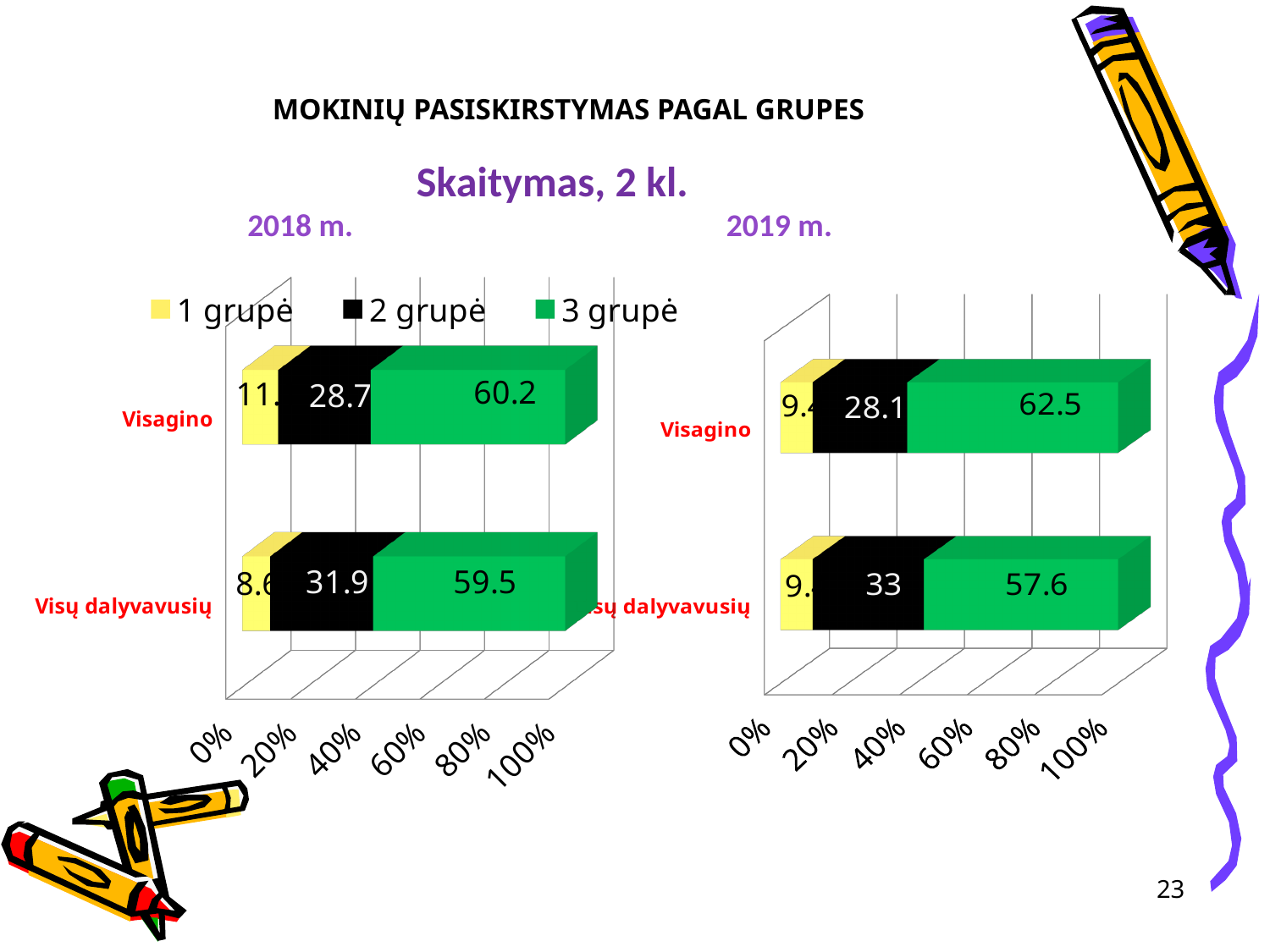
In the 2019 m. chart, what is the value of 3 grupė for Visų dalyvavusių? 57.6 In the 2018 m. chart, what is the value of 1 grupė for Visų dalyvavusių? 8.6 In the 2019 m. chart, what is the value of 3 grupė for Visagino? 62.5 In the 2018 m. chart, which category has the larger 3 grupė value, Visagino or Visų dalyvavusių? Visagino In the 2019 m. chart, what is the value of 2 grupė for Visų dalyvavusių? 33 What are the legend entries shown above the 2018 m. chart? 1 grupė, 2 grupė, 3 grupė In the 2018 m. chart, what is the value of 3 grupė for Visagino? 60.2 What kind of chart is the 2018 m. chart? Stacked bar chart In the 2018 m. chart, what is the value of 2 grupė for Visų dalyvavusių? 31.9 In the 2019 m. chart, what is the difference between the 3 grupė values for Visagino and Visų dalyvavusių? 4.9 How many categories are shown in the 2019 m. chart? 2 How many series does the legend list for the charts? 3